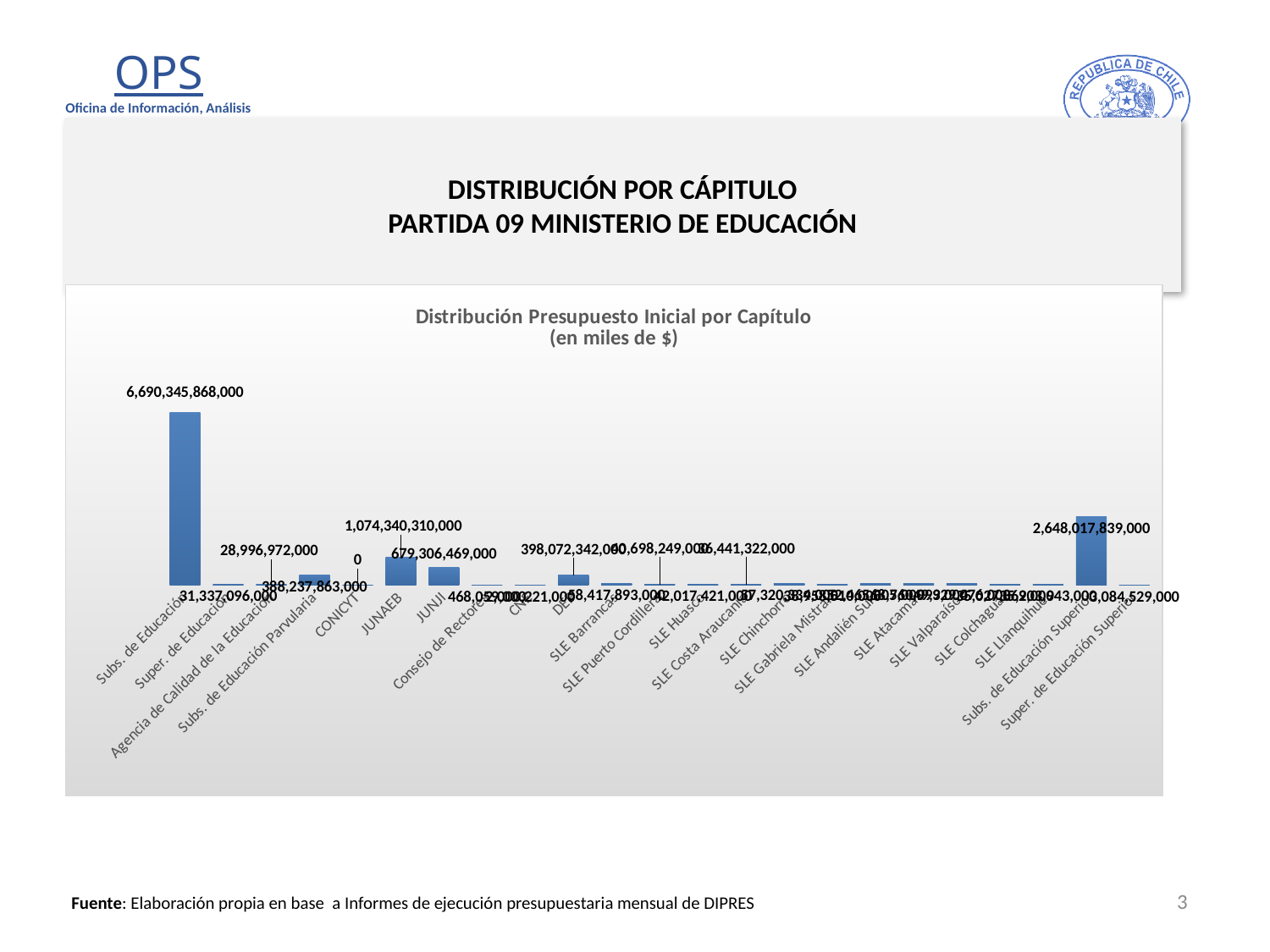
What kind of chart is shown on the slide? Bar chart What is the value shown for Super. de Educación? 31,337,096,000 Which capítulo has the highest initial budget in the chart? Subs. de Educación What is the value shown for JUNAEB? 1,074,340,310,000 What is the value shown for Subs. de Educación? 6,690,345,868,000 What is the title of the chart? Distribución Presupuesto Inicial por Capítulo (en miles de $) What is the value shown for JUNJI? 679,306,469,000 What is the value shown for Subs. de Educación Superior? 2,648,017,839,000 Which is larger, the value for JUNAEB or the value for JUNJI? JUNAEB What is the value shown for CONICYT? 0 What is the difference between the values for JUNAEB and JUNJI? 395,033,841,000 What is the difference between the values for Subs. de Educación and Subs. de Educación Superior? 4,042,328,029,000